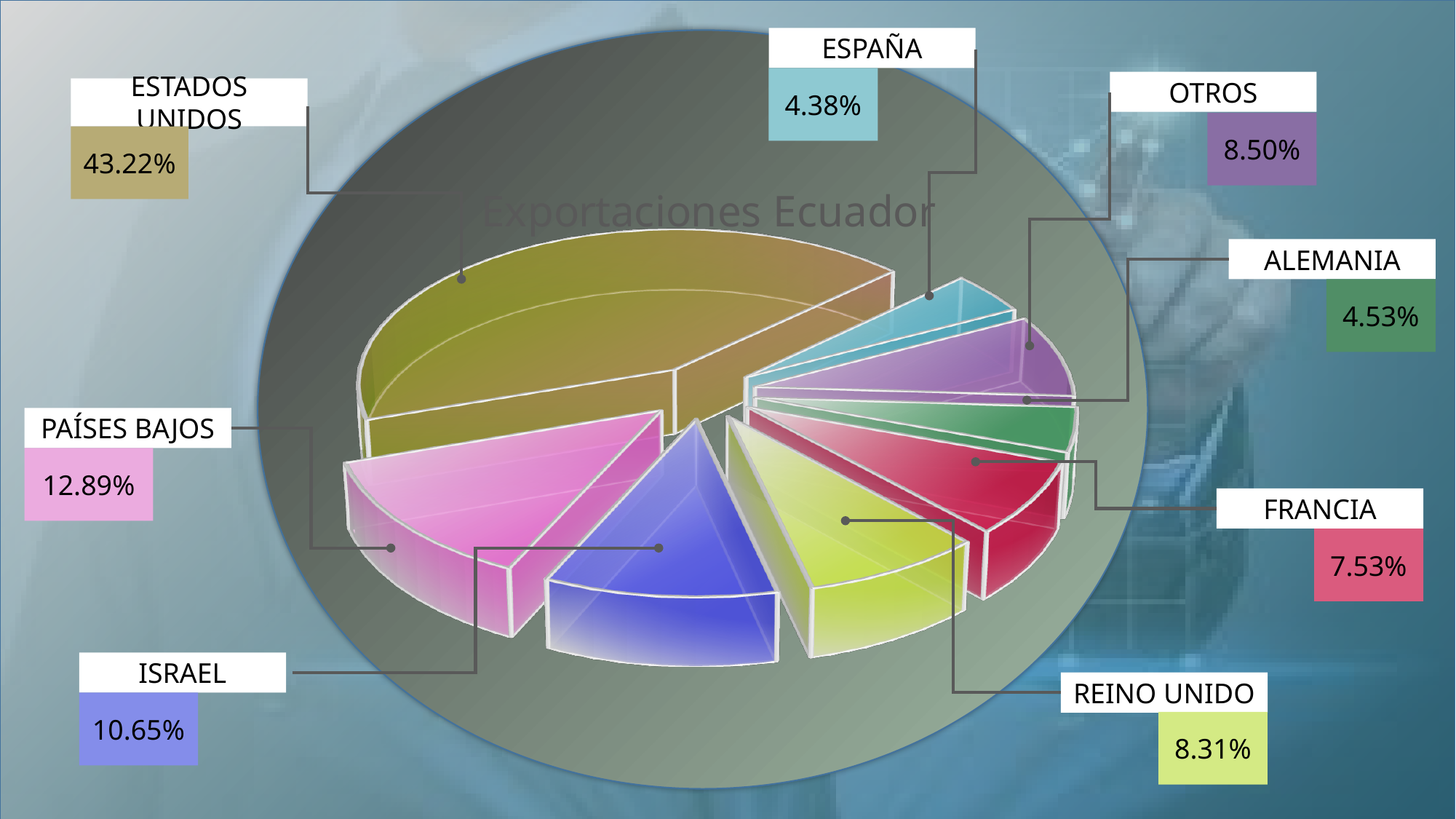
What colour is the slice for ISRAEL? Blue Which is larger, the share for OTROS or the share for FRANCIA? OTROS What is the value shown for REINO UNIDO? 8.31% What is the title of the chart? Exportaciones Ecuador What share of the pie does ESTADOS UNIDOS have? 43.22% How many slices does the pie chart have? 8 What is the value shown for ALEMANIA? 4.53% Which category has the smallest share of the pie? ESPAÑA Which category has the largest share of the pie? ESTADOS UNIDOS What kind of chart is shown on the slide? Pie chart What is the difference between the shares of PAÍSES BAJOS and ISRAEL? 2.24% What is the value shown for PAÍSES BAJOS? 12.89%